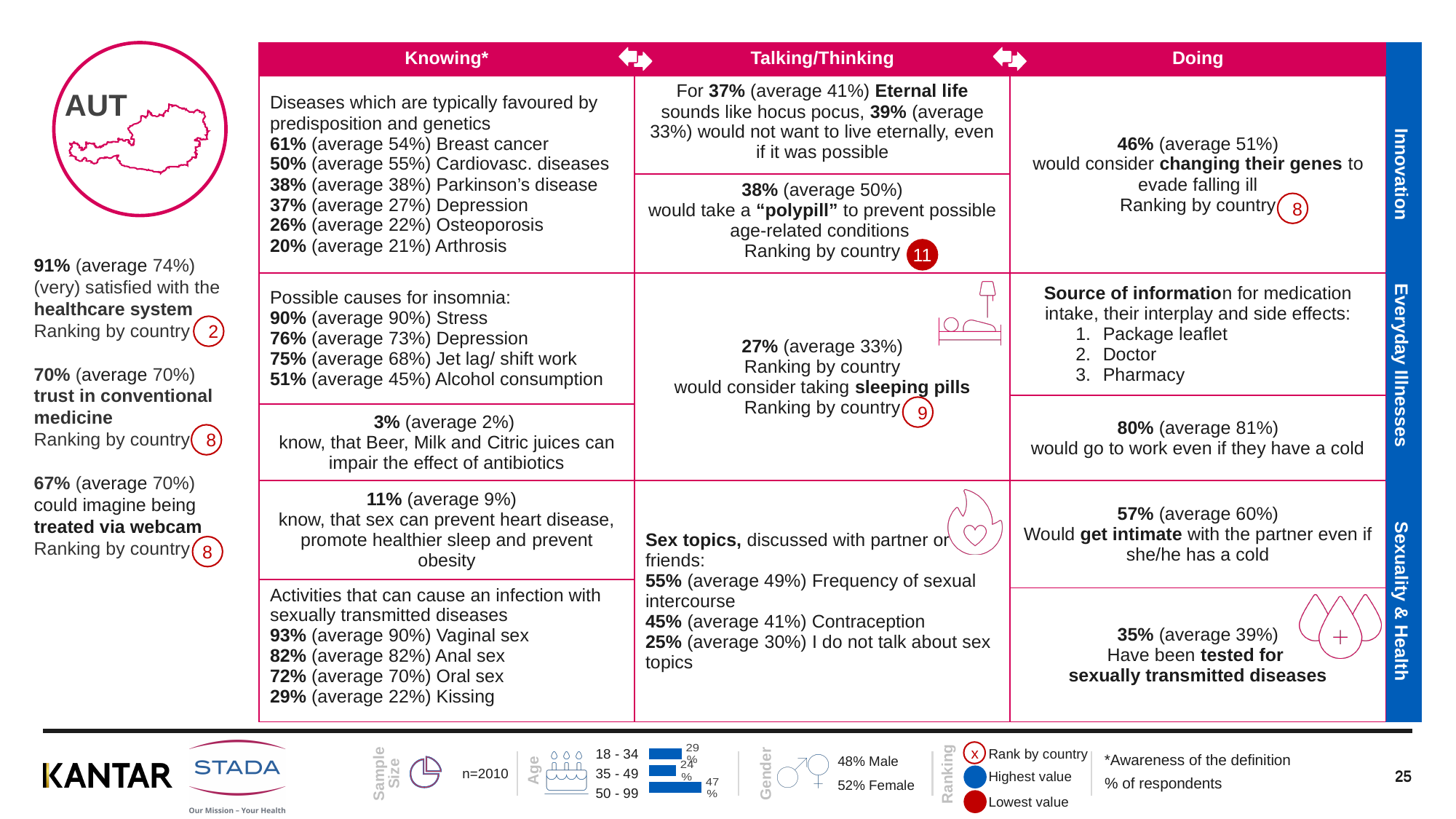
In the Age bar chart at the bottom of the slide, which is larger: the value for 18 - 34 or the value for 50 - 99? 50 - 99 In the Age bar chart at the bottom of the slide, what is the difference between the 18 - 34 value and the 35 - 49 value? 5% In the Age bar chart at the bottom of the slide, what colour are the bars? blue In the Age bar chart at the bottom of the slide, how many age groups are plotted? 3 In the Age bar chart at the bottom of the slide, which age group has the highest share of respondents? 50 - 99 In the Age bar chart at the bottom of the slide, what is the sample size (n) shown next to the chart? n=2010 In the Age bar chart at the bottom of the slide, what is the difference between the 50 - 99 value and the 35 - 49 value? 23% In the Age bar chart at the bottom of the slide, what is the value for the 18 - 34 age group? 29% In the Age bar chart at the bottom of the slide, what is the value for the 50 - 99 age group? 47% In the Age bar chart at the bottom of the slide, which age group has the lowest share of respondents? 35 - 49 In the Age bar chart at the bottom of the slide, what kind of chart is shown? bar chart In the Age bar chart at the bottom of the slide, what is the value for the 35 - 49 age group? 24%